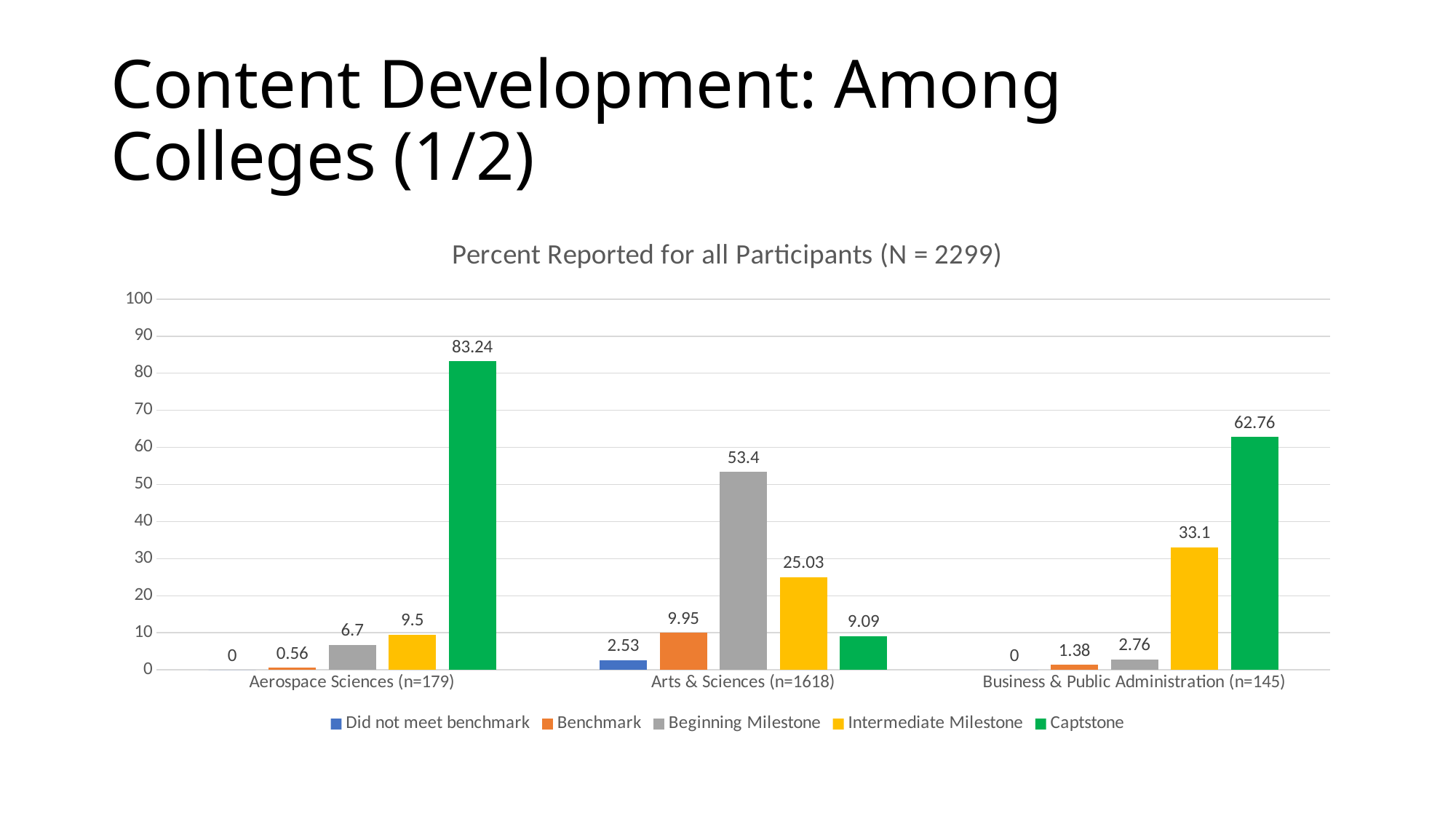
How many series does the legend list? 5 What kind of chart is shown on the slide? Bar chart What is the Beginning Milestone value for Arts & Sciences (n=1618)? 53.4 How many colleges are shown on the x axis? 3 Which college has the lowest Beginning Milestone value? Business & Public Administration (n=145) What is the Captstone value for Aerospace Sciences (n=179)? 83.24 Which is larger for Arts & Sciences (n=1618): Beginning Milestone or Intermediate Milestone? Beginning Milestone What is the Intermediate Milestone value for Business & Public Administration (n=145)? 33.1 What is the title of the chart? Percent Reported for all Participants (N = 2299) Which college has the highest Captstone value? Aerospace Sciences (n=179) What is the difference between the Captstone values for Aerospace Sciences (n=179) and Business & Public Administration (n=145)? 20.48 What is the Benchmark value for Arts & Sciences (n=1618)? 9.95